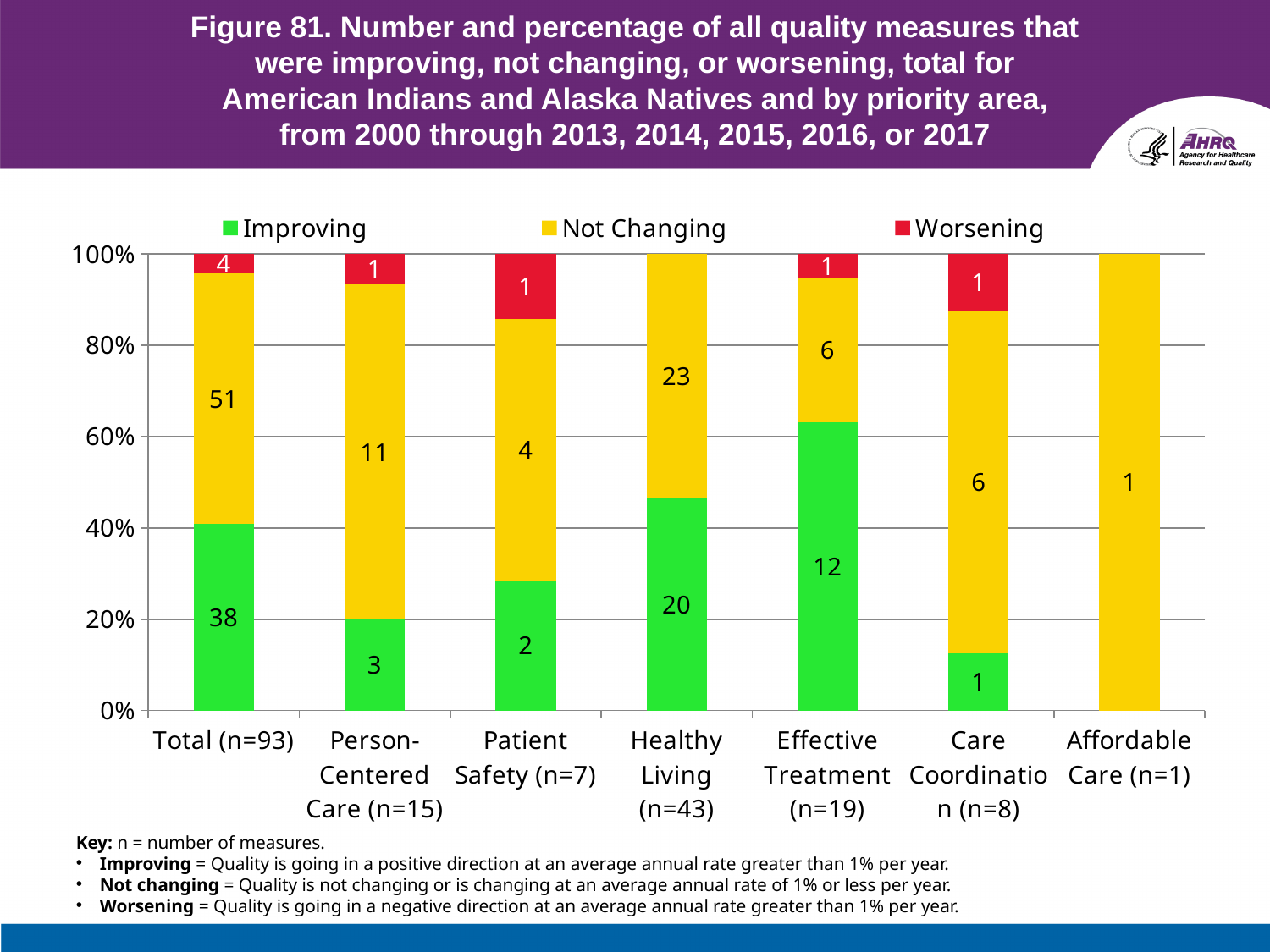
How many Worsening measures are shown for Patient Safety (n=7)? 1 Is the Improving share of the Care Coordination (n=8) bar greater or less than 20%? less How many series does the legend list? 3 How many Improving measures are shown for Effective Treatment (n=19)? 12 How many categories are shown on the x axis? 7 Which is larger for Effective Treatment (n=19): the Improving count or the Not Changing count? Improving What kind of chart is this? Stacked bar chart How many Improving measures are shown for Total (n=93)? 38 Which priority area (excluding Total) has the highest number of Not Changing measures? Healthy Living (n=43) What is the difference between the Not Changing and Improving counts for Total (n=93)? 13 Is the Improving share of the Effective Treatment (n=19) bar greater or less than 60%? greater How many Not Changing measures are shown for Healthy Living (n=43)? 23